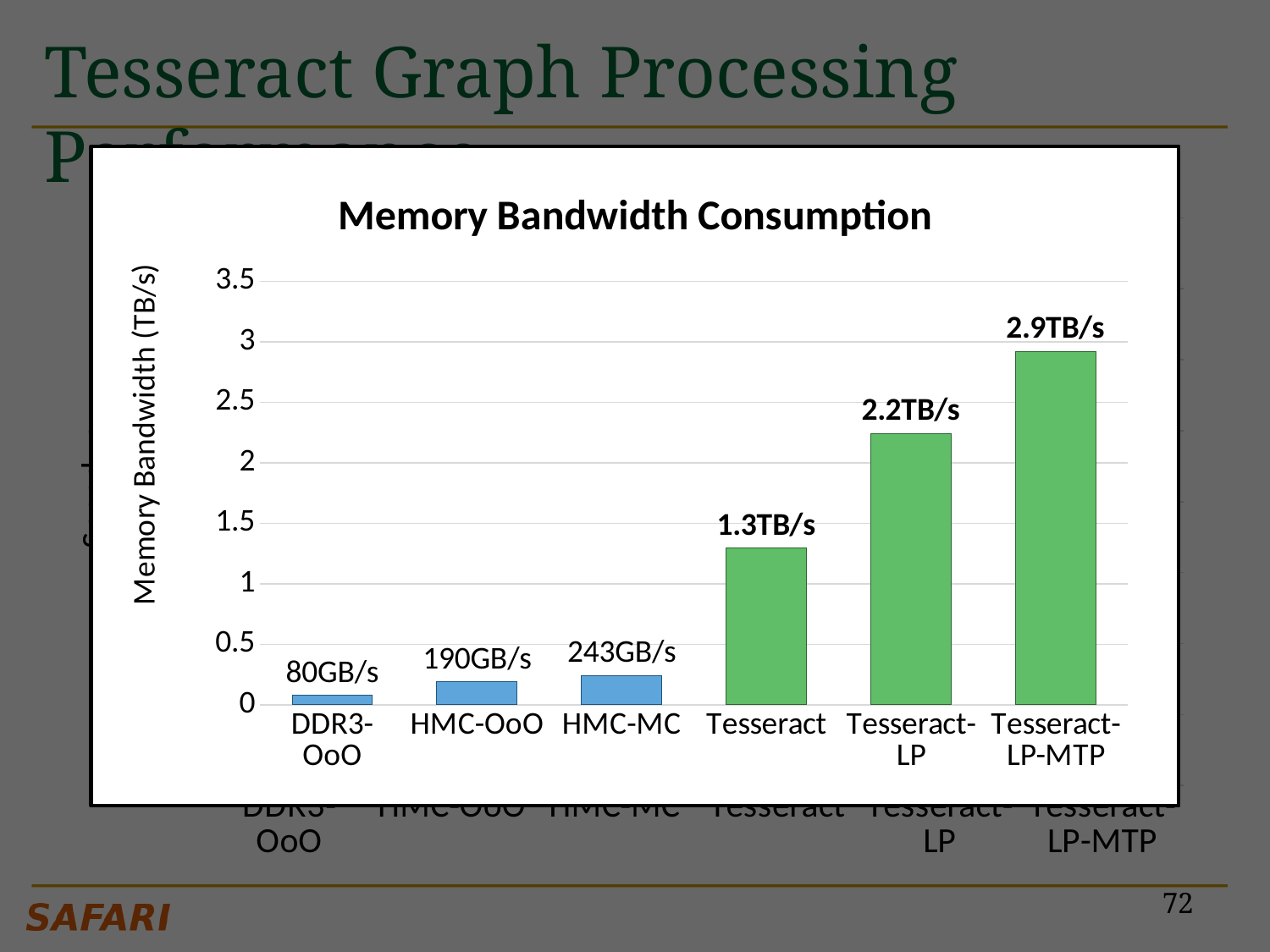
Which has higher memory bandwidth consumption, HMC-OoO or Tesseract? Tesseract What is the memory bandwidth consumption for HMC-MC? 243GB/s What is the memory bandwidth consumption for Tesseract-LP-MTP? 2.9TB/s What is the memory bandwidth consumption for Tesseract? 1.3TB/s What is the memory bandwidth consumption for DDR3-OoO? 80GB/s Which configuration has the highest memory bandwidth consumption? Tesseract-LP-MTP What is the difference in memory bandwidth between HMC-MC and HMC-OoO? 53GB/s What is the title of the chart? Memory Bandwidth Consumption Which configuration has the lowest memory bandwidth consumption? DDR3-OoO What type of chart is shown on the slide? Bar chart What is the difference in memory bandwidth between Tesseract-LP-MTP and Tesseract-LP? 0.7TB/s How many configurations are shown in the chart? 6